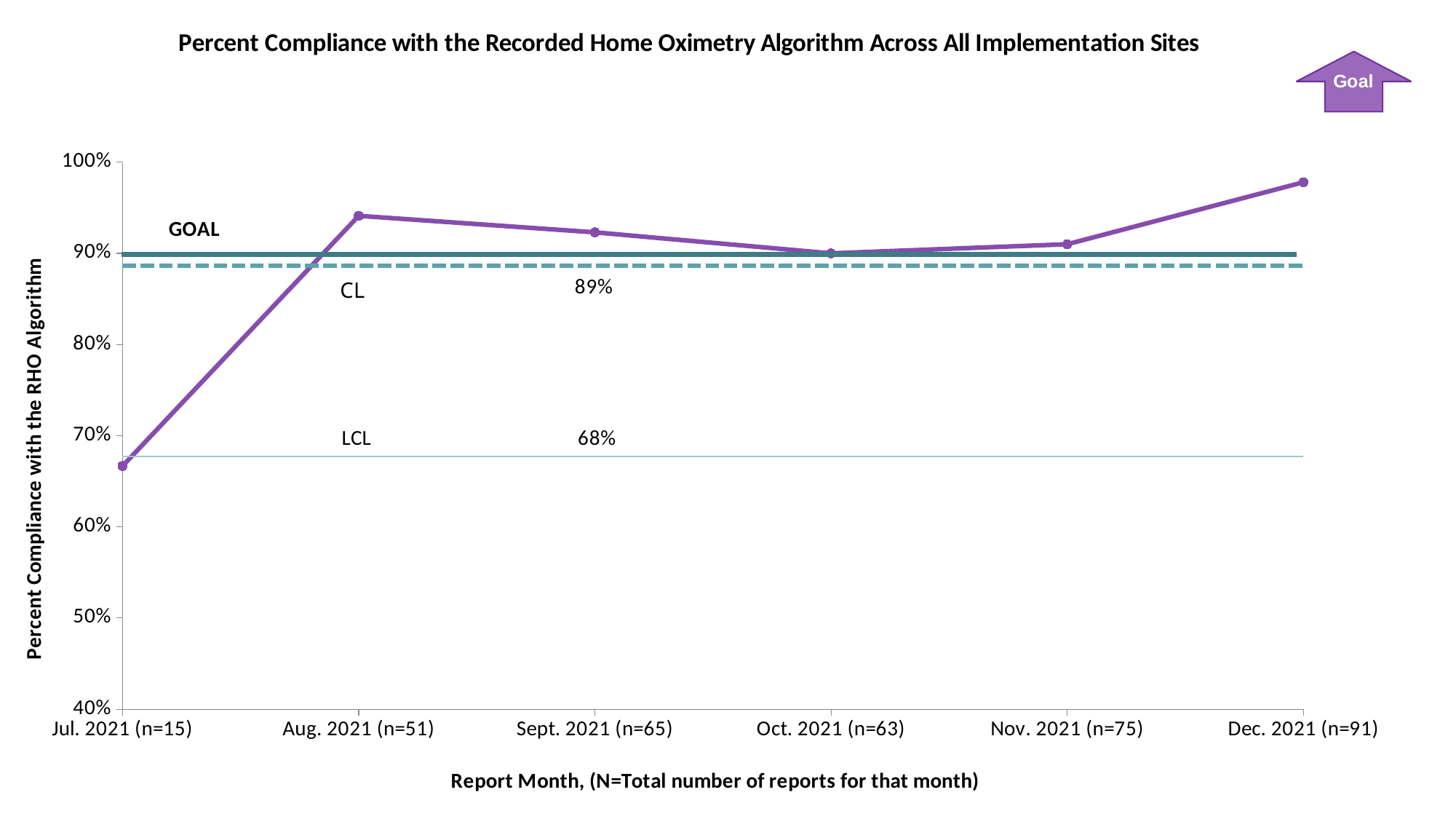
Do the values rise or fall from Jul. 2021 to Aug. 2021? rise Is the value for Jul. 2021 greater or less than 70%? less What kind of chart is shown on the slide? line chart What value is labelled for the CL (center line)? 89% Which report month has the highest percent compliance? Dec. 2021 (n=91) Is the value for Dec. 2021 greater or less than 90%? greater Which is larger, the value for Aug. 2021 or the value for Sept. 2021? Aug. 2021 What is the title of the chart? Percent Compliance with the Recorded Home Oximetry Algorithm Across All Implementation Sites Which report month has the lowest percent compliance? Jul. 2021 (n=15) How many report months are plotted on the x axis? 6 What value is labelled for the LCL (lower control limit)? 68% Is the value for Aug. 2021 greater or less than 90%? greater